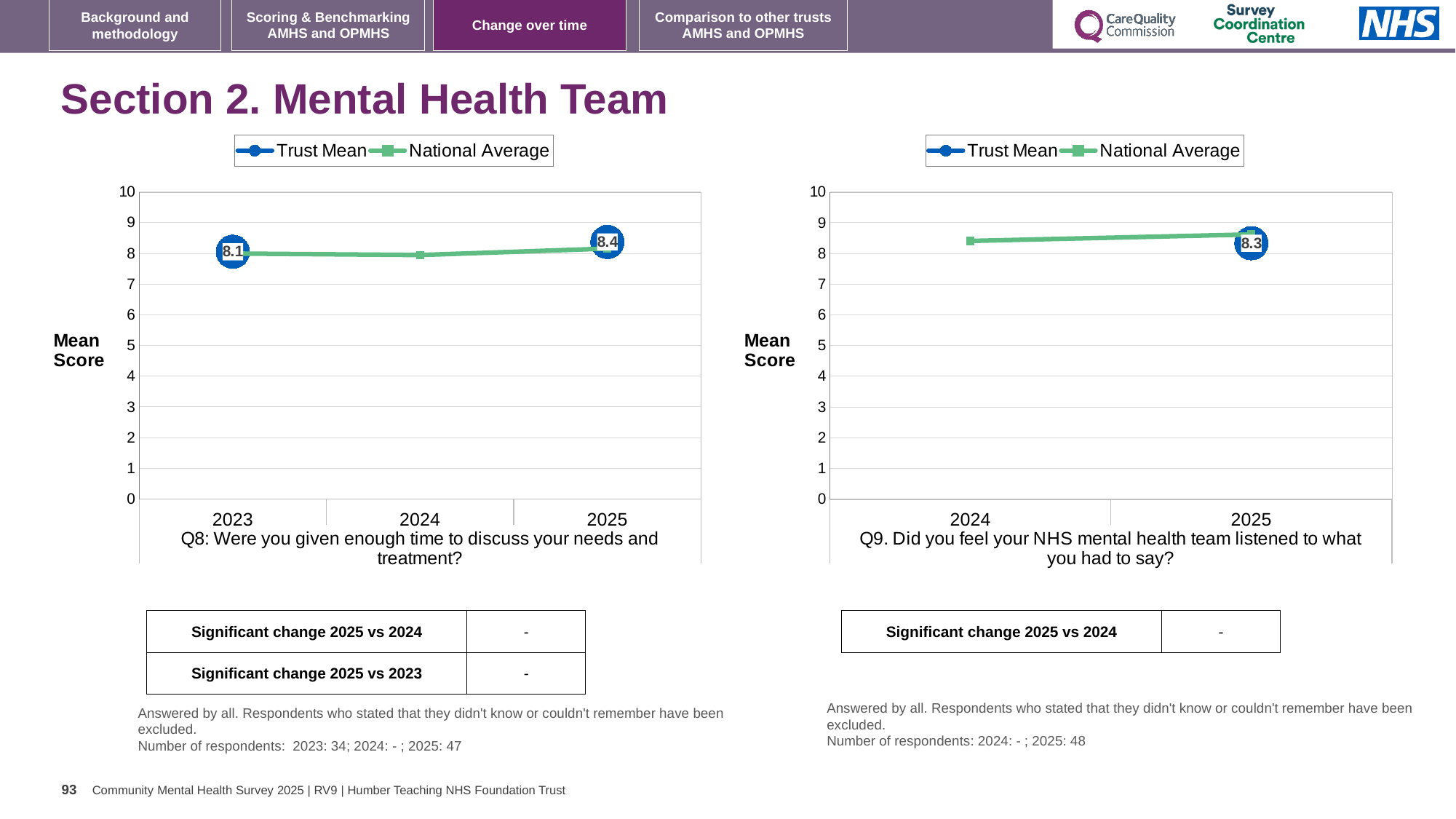
On the left chart (Q8), which year has the higher Trust Mean, 2023 or 2025? 2025 How many years are shown on the x axis of the left chart (Q8)? 3 On the right chart (Q9), is the National Average for 2024 greater or less than 8? greater On the left chart (Q8), what is the difference between the Trust Mean in 2025 and in 2023? 0.3 On the left chart (Q8), is the National Average for 2024 greater or less than 9? less On the left chart (Q8), does the Trust Mean rise or fall from 2023 to 2025? rise How many years are shown on the x axis of the right chart (Q9)? 2 What type of chart is the left chart (Q8)? line chart On the left chart (Q8), what is the Trust Mean for 2023? 8.1 On the right chart (Q9), what is the Trust Mean for 2025? 8.3 On the left chart (Q8), what is the Trust Mean for 2025? 8.4 How many series does the legend of the right chart (Q9) list? 2